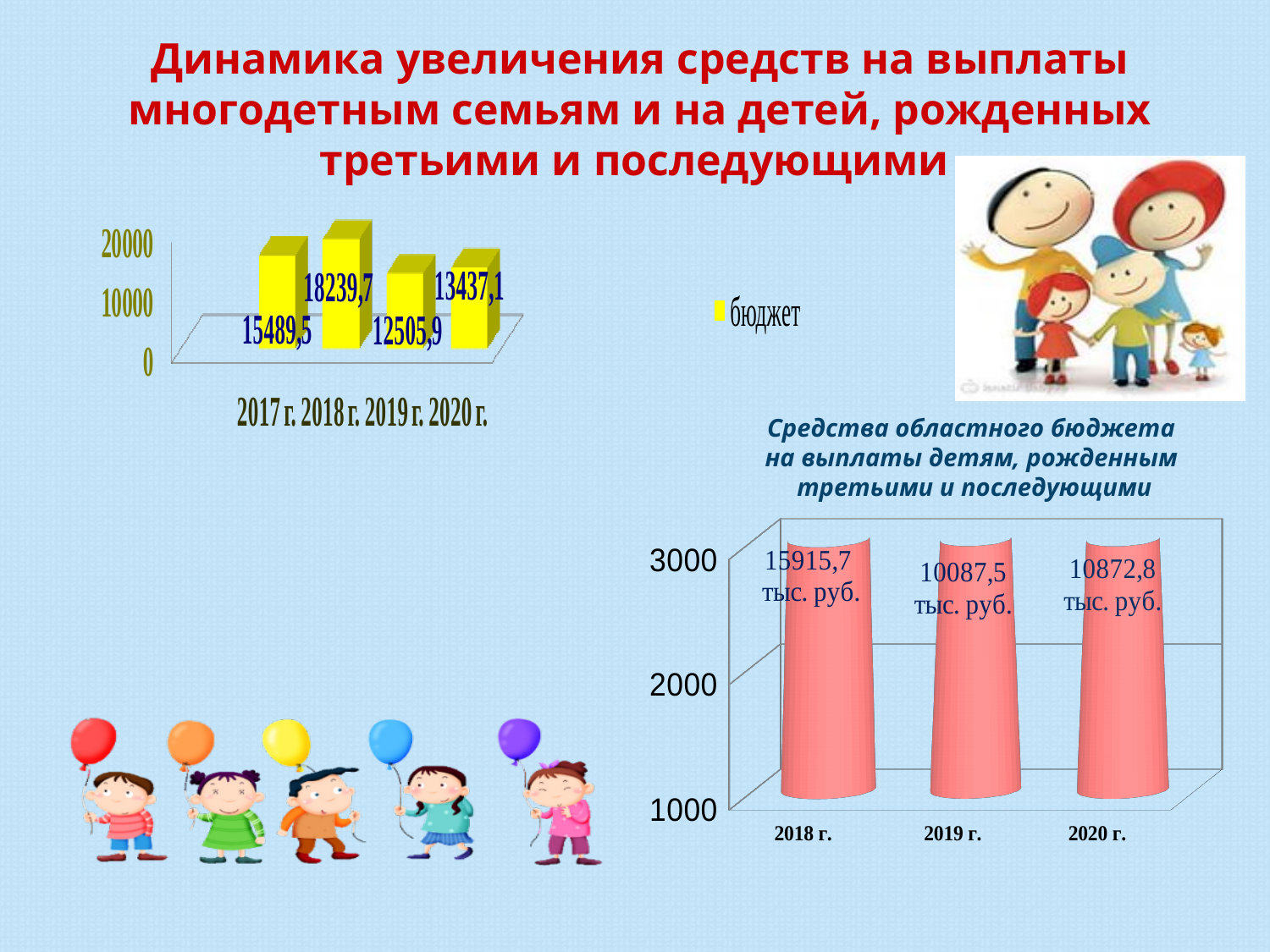
In the yellow bar chart on the left, is the value for 2017 г. greater or less than 10000? greater In the yellow bar chart on the left, what is the single legend entry? бюджет In the yellow bar chart on the left, which year has the highest value? 2018 г. In the yellow bar chart on the left, how many years are shown on the x axis? 4 In the chart titled 'Средства областного бюджета на выплаты детям, рожденным третьими и последующими', what is the difference between the values for 2018 г. and 2019 г.? 5828,2 тыс. руб. In the yellow bar chart on the left, what is the value for 2018 г.? 18239,7 In the yellow bar chart on the left, what is the value for 2019 г.? 12505,9 What kind of chart is the one titled 'Средства областного бюджета на выплаты детям, рожденным третьими и последующими'? bar chart In the yellow bar chart on the left, what is the difference between the values for 2018 г. and 2017 г.? 2750,2 In the chart titled 'Средства областного бюджета на выплаты детям, рожденным третьими и последующими', what is the value for 2018 г.? 15915,7 тыс. руб. In the chart titled 'Средства областного бюджета на выплаты детям, рожденным третьими и последующими', which year has the lowest value? 2019 г. In the yellow bar chart on the left, which year has the lowest value? 2019 г.